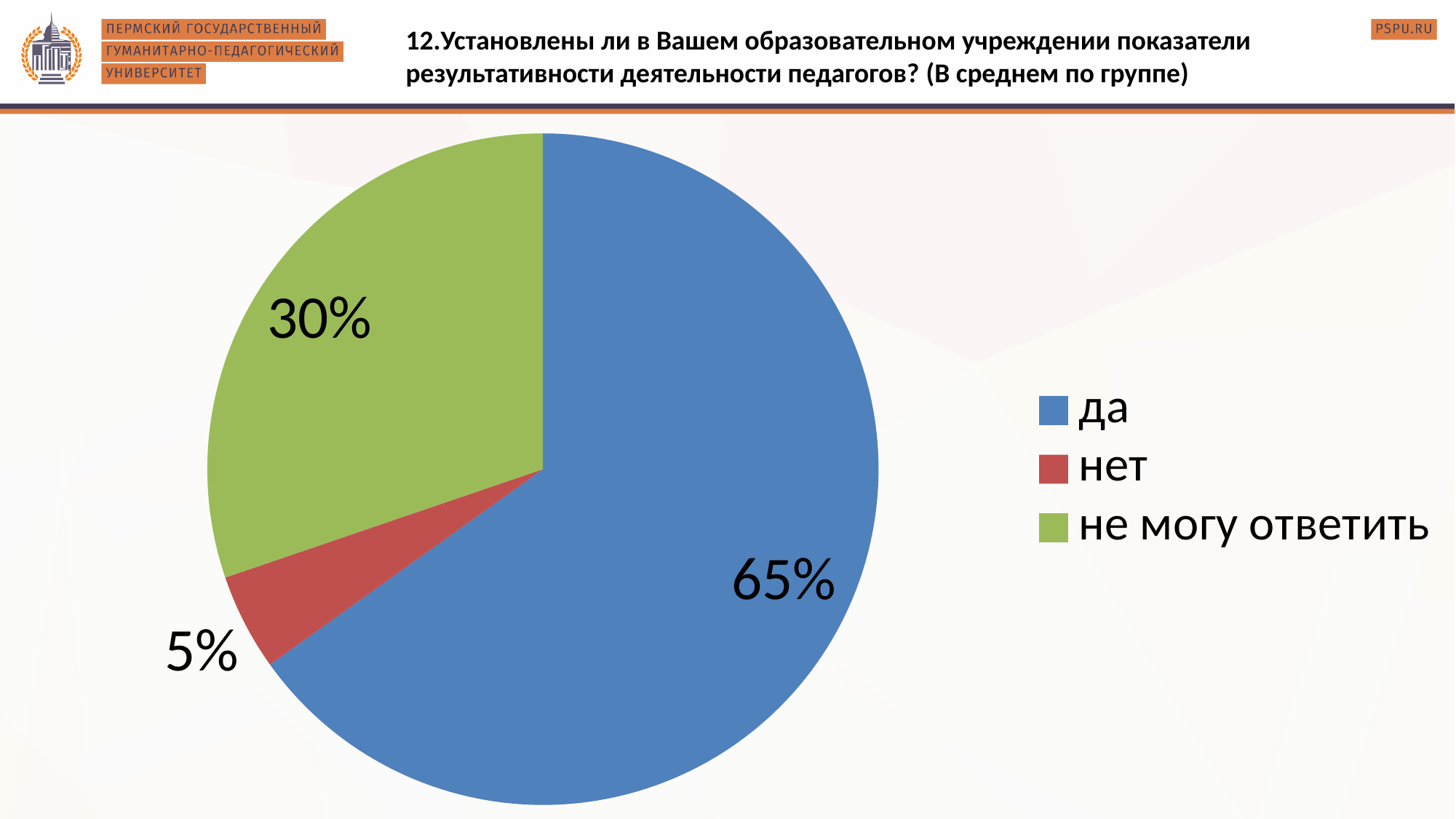
Which answer option has the smallest share of the pie? нет What percentage of respondents answered "да"? 65% What is the difference in percentage points between "да" and "не могу ответить"? 35 What percentage of respondents answered "не могу ответить"? 30% Which is larger, the share for "нет" or the share for "не могу ответить"? не могу ответить What colour is the slice for "да"? blue How many slices does the pie chart have? 3 What type of chart is shown on the slide? pie chart Which answer option has the largest share of the pie? да What percentage of respondents answered "нет"? 5% How many entries does the legend list? 3 What colour is the slice for "не могу ответить"? green